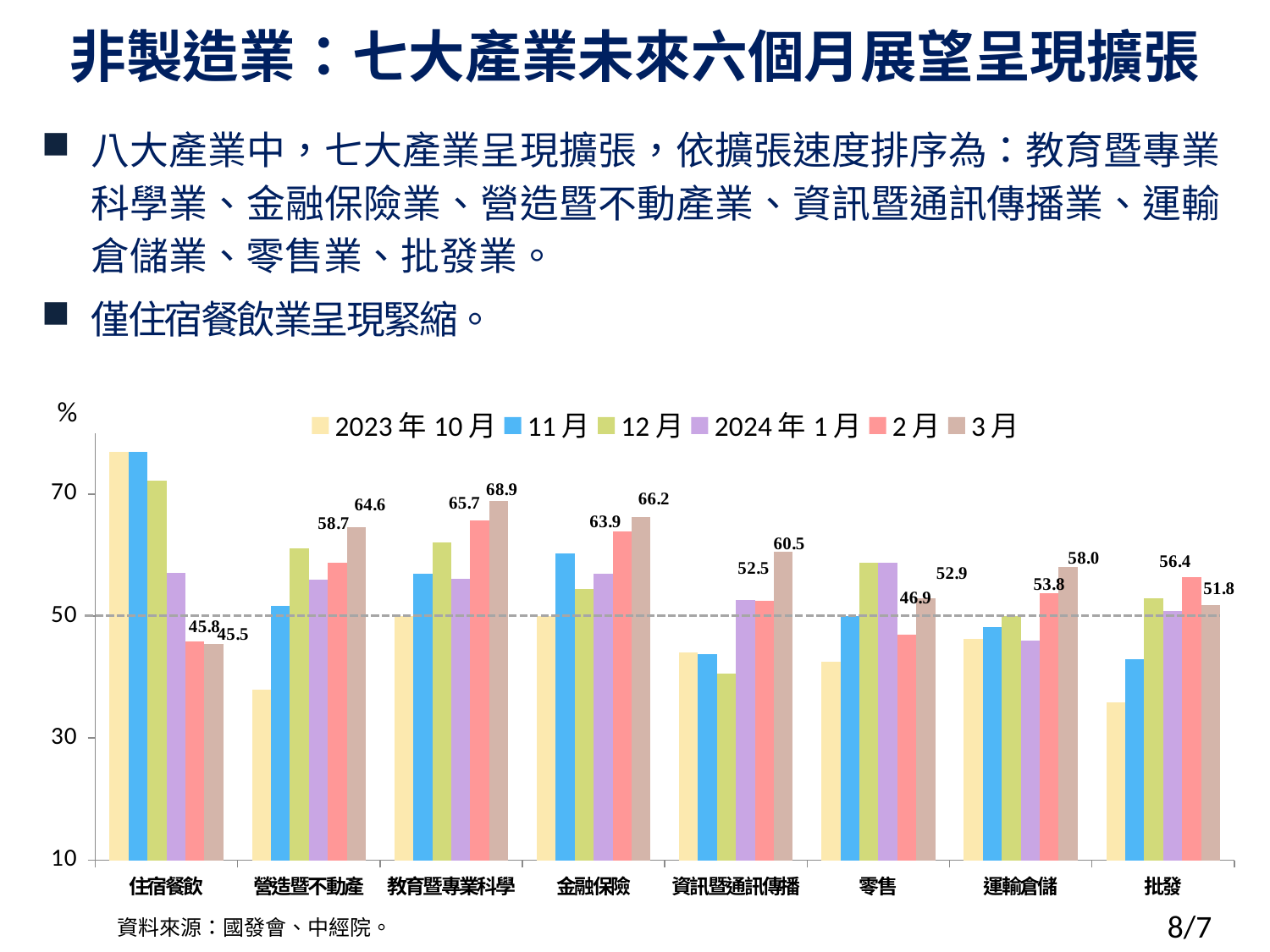
What is the value for 教育暨專業科學 in the 3月 series? 68.9 Which category has the lowest value in the 3月 series? 住宿餐飲 Which is larger for 批發: the 2月 value or the 3月 value? 2月 What is the value for 批發 in the 2月 series? 56.4 What kind of chart is shown on the slide? bar chart What is the difference between the 3月 and 2月 values for 資訊暨通訊傳播? 8.0 Is the value for 營造暨不動產 in the 2023年10月 series greater or less than 50? less Is the value for 住宿餐飲 in the 2023年10月 series greater or less than 70? greater Which category has the highest value in the 3月 series? 教育暨專業科學 How many industry categories are shown on the x axis? 8 How many series does the legend list? 6 What is the value for 零售 in the 3月 series? 52.9